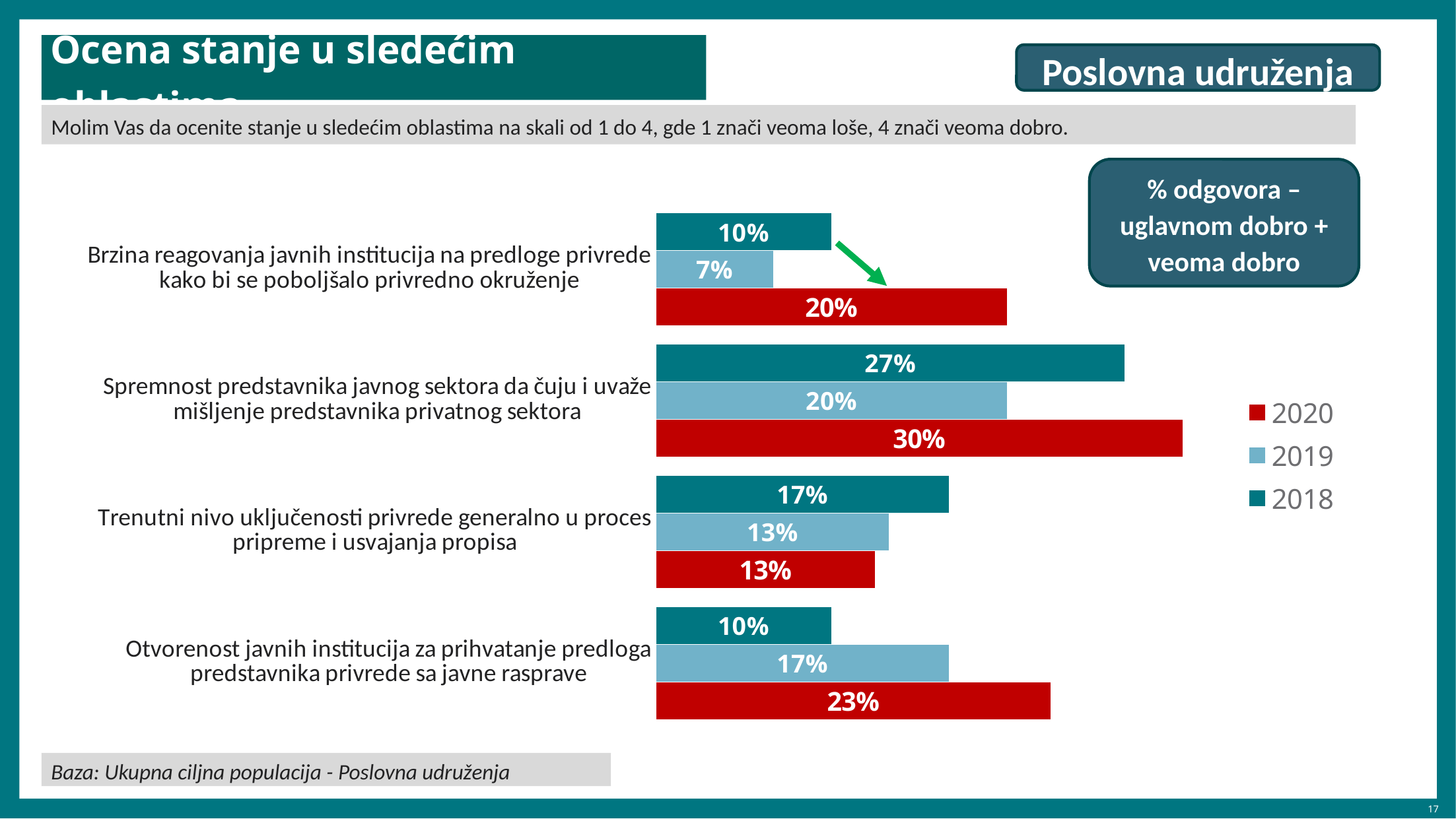
Which category has the highest 2020 value? Spremnost predstavnika javnog sektora da čuju i uvaže mišljenje predstavnika privatnog sektora What is the 2020 value for "Spremnost predstavnika javnog sektora da čuju i uvaže mišljenje predstavnika privatnog sektora"? 30% What is the 2019 value for "Brzina reagovanja javnih institucija na predloge privrede kako bi se poboljšalo privredno okruženje"? 7% Which series is shown in red in the legend? 2020 What is the 2018 value for "Otvorenost javnih institucija za prihvatanje predloga predstavnika privrede sa javne rasprave"? 10% What kind of chart is shown on the slide? bar chart Which category has the lowest 2019 value? Brzina reagovanja javnih institucija na predloge privrede kako bi se poboljšalo privredno okruženje What is the difference between the 2020 and 2019 values for "Otvorenost javnih institucija za prihvatanje predloga predstavnika privrede sa javne rasprave"? 6% How many categories are plotted in the chart? 4 For "Trenutni nivo uključenosti privrede generalno u proces pripreme i usvajanja propisa", which is larger: the 2018 value or the 2020 value? 2018 What is the difference between the 2020 and 2018 values for "Brzina reagovanja javnih institucija na predloge privrede kako bi se poboljšalo privredno okruženje"? 10% How many series does the legend list? 3